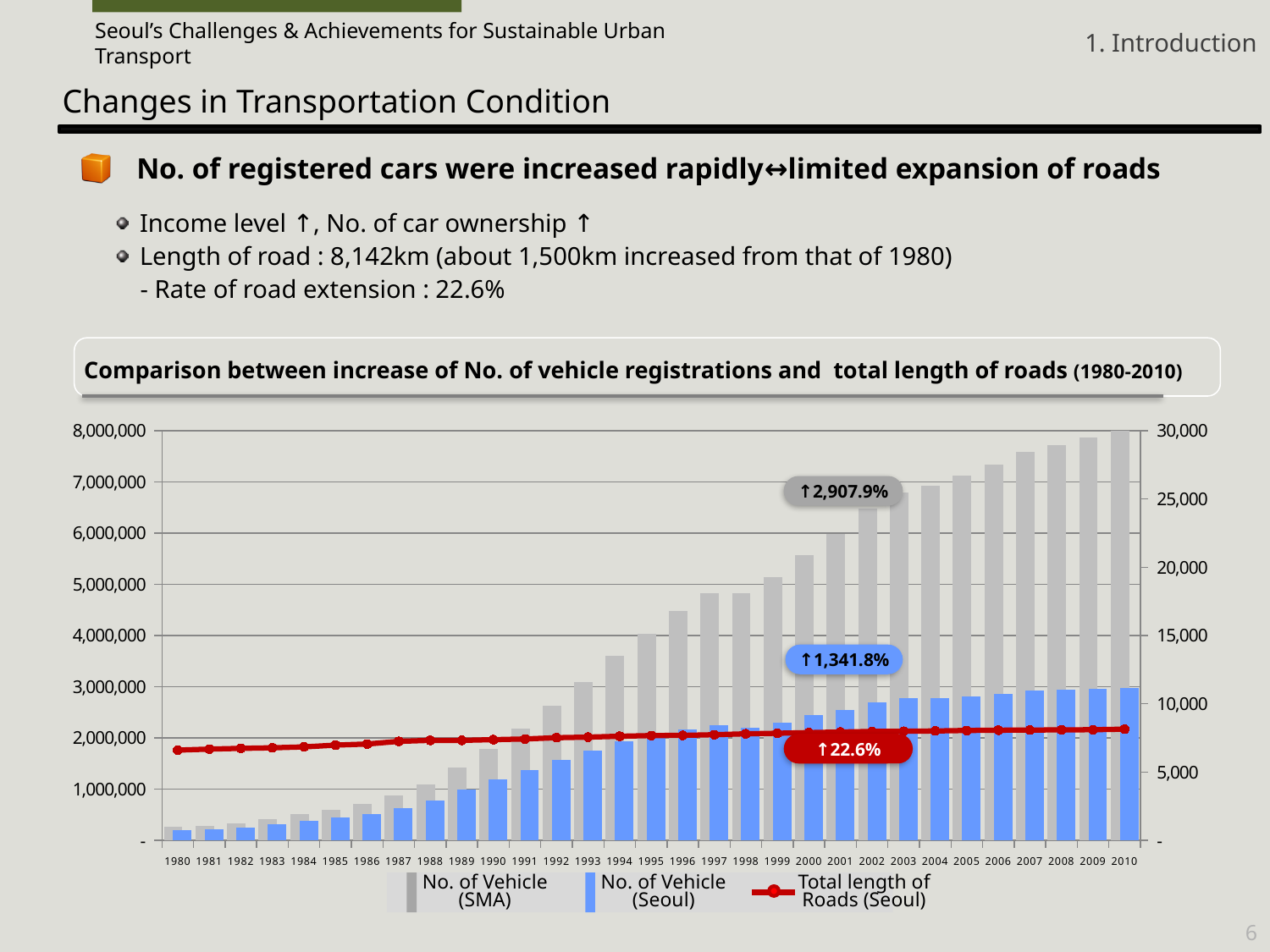
Is the Total length of Roads (Seoul) in 2010 greater or less than 10,000 on the right axis? less Is the value for No. of Vehicle (SMA) in 2000 greater or less than 5,000,000? greater Is the value for No. of Vehicle (Seoul) in 1990 greater or less than 1,000,000? greater Which year has the highest value for No. of Vehicle (SMA)? 2010 How many series does the chart legend list? 3 What kind of chart is shown on the slide? Combination bar and line chart Do the No. of Vehicle (SMA) bars rise or fall from 1980 to 2010? Rise How many years are shown along the x axis of the chart? 31 Which year has the lowest value for No. of Vehicle (Seoul)? 1980 What percentage increase is labelled on the chart for the Total length of Roads (Seoul)? ↑22.6% In 2005, which is larger: No. of Vehicle (SMA) or No. of Vehicle (Seoul)? No. of Vehicle (SMA)